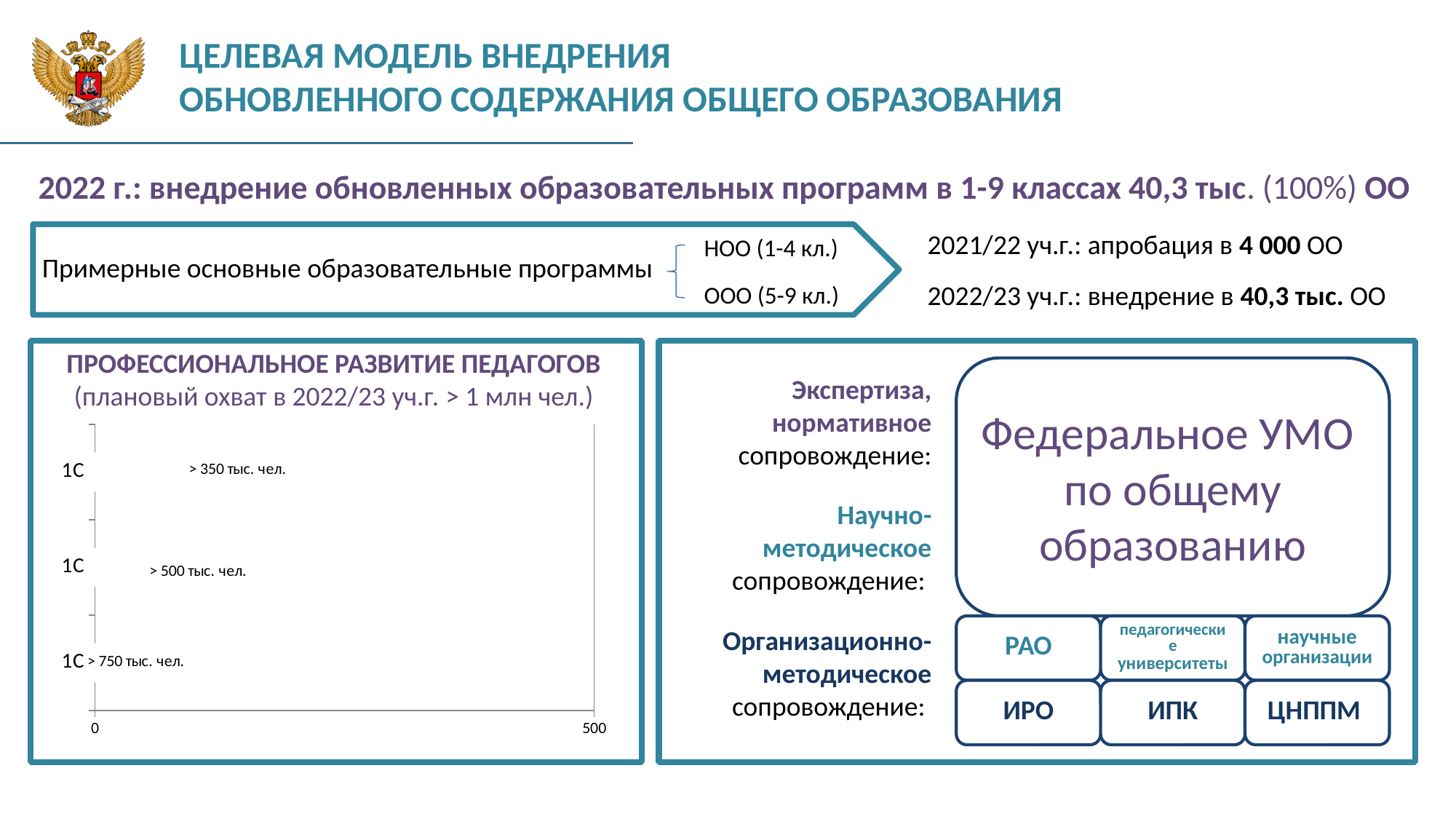
What is the data label on the top bar of the chart? > 350 тыс. чел. What is the title of the chart panel on the left of the slide? ПРОФЕССИОНАЛЬНОЕ РАЗВИТИЕ ПЕДАГОГОВ Do the data label values increase or decrease going from the top bar to the bottom bar? increase Which bar of the chart has the largest data label value: top, middle or bottom? bottom Which bar of the chart has the smallest data label value: top, middle or bottom? top What is the data label on the middle bar of the chart? > 500 тыс. чел. How many categories (bars) does the chart in the 'ПРОФЕССИОНАЛЬНОЕ РАЗВИТИЕ ПЕДАГОГОВ' panel have? 3 What is the data label on the bottom bar of the chart? > 750 тыс. чел. What kind of chart is shown in the 'ПРОФЕССИОНАЛЬНОЕ РАЗВИТИЕ ПЕДАГОГОВ' panel? bar chart What is the maximum tick value shown on the horizontal axis of the chart? 500